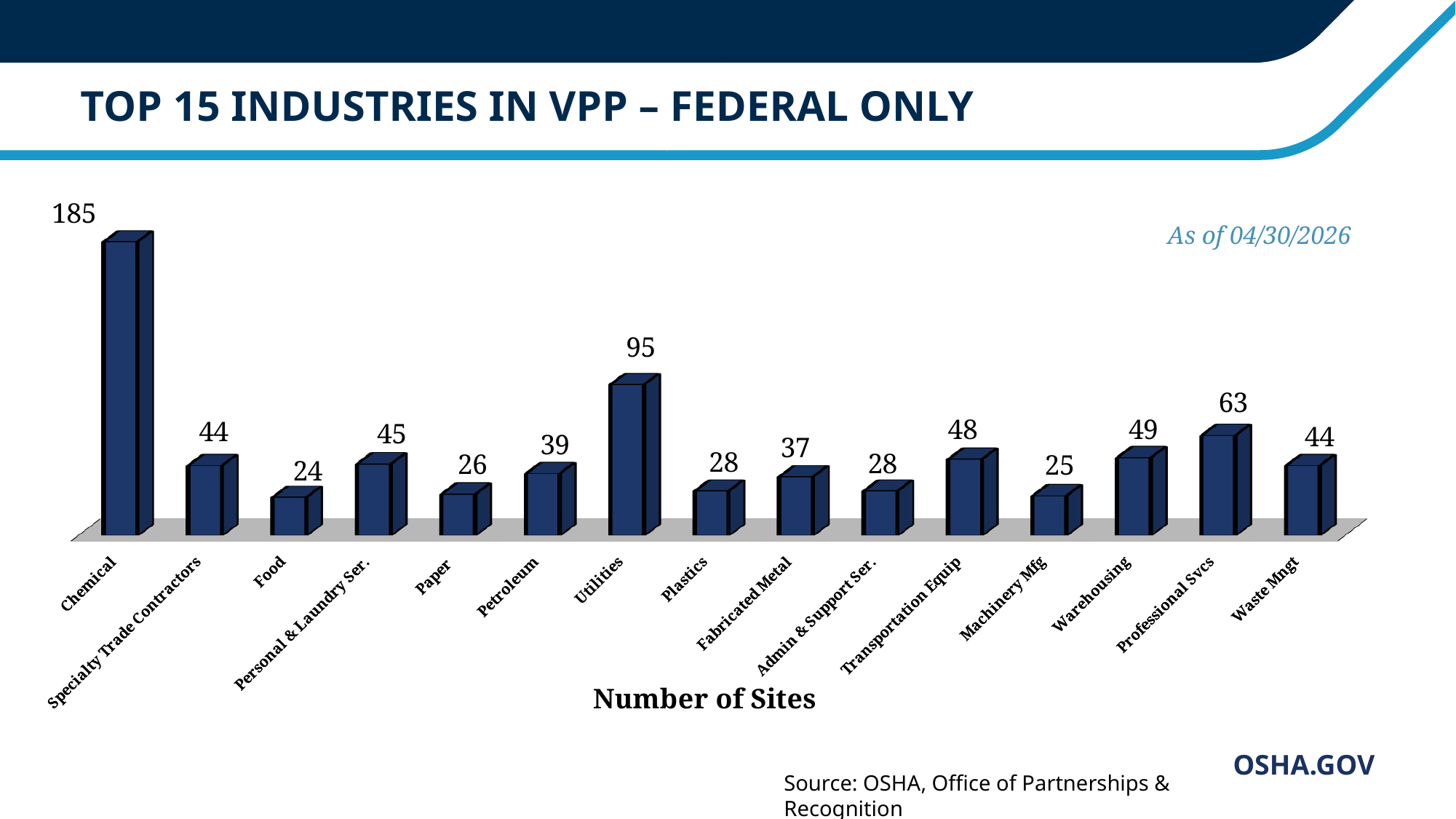
What is the number of sites for Chemical? 185 What is the number of sites for Machinery Mfg? 25 What is the number of sites for Professional Svcs? 63 Which has more sites, Warehousing or Transportation Equip? Warehousing What is the difference in number of sites between Chemical and Utilities? 90 What is the difference in number of sites between Professional Svcs and Waste Mngt? 19 What is the title of the chart? Top 15 Industries in VPP – Federal Only What is the number of sites for Utilities? 95 How many industries are shown in the chart? 15 Which industry has the lowest number of sites? Food Which industry has the highest number of sites? Chemical What kind of chart is shown on the slide? Bar chart